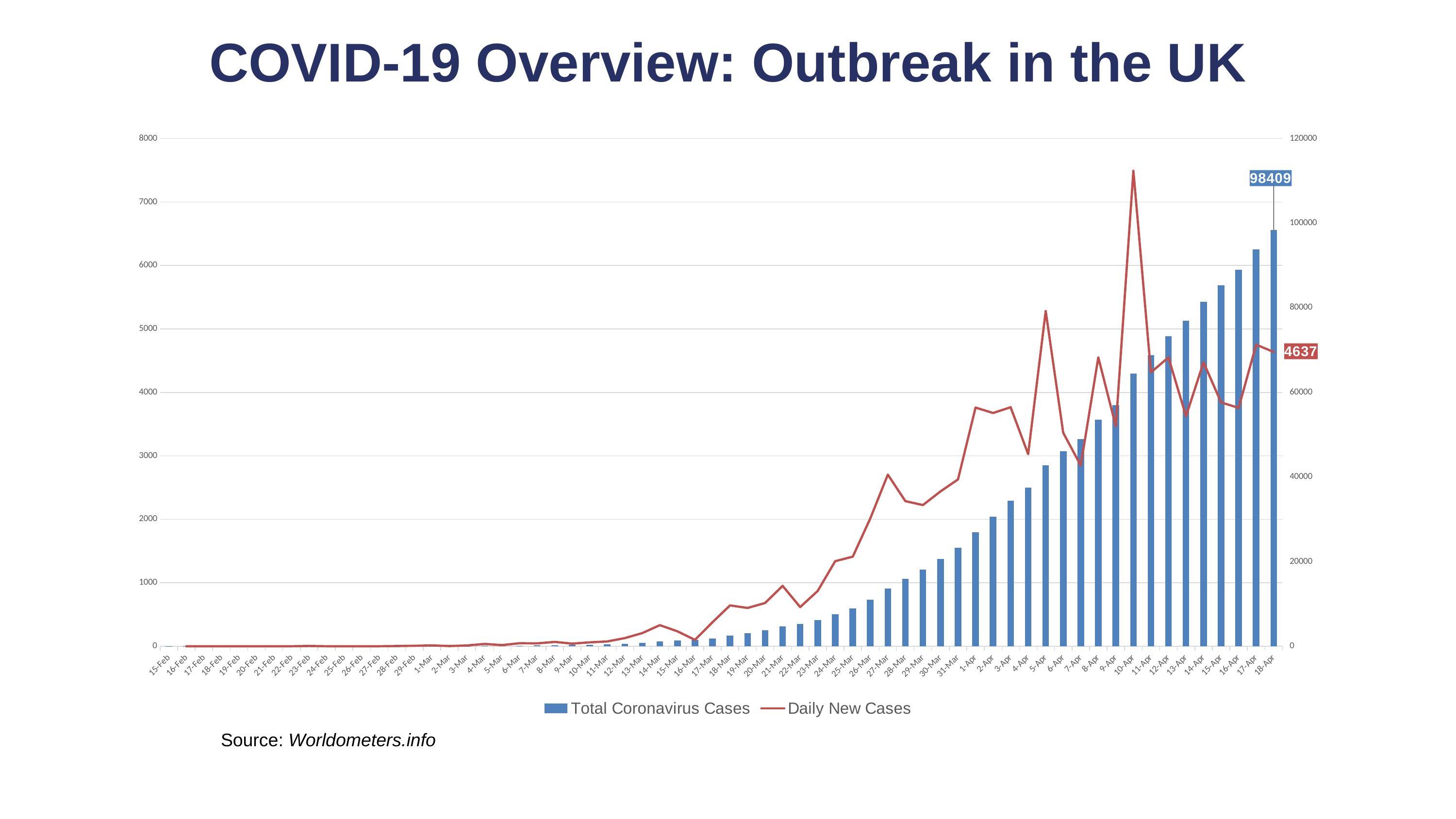
On which date does the Daily New Cases line reach its highest point? 10-Apr What kind of chart is shown on the slide? A bar chart combined with a line chart What is the value of Total Coronavirus Cases on 18-Apr? 98409 Which date has the larger value of Daily New Cases, 5-Apr or 6-Apr? 5-Apr Is the value of Total Coronavirus Cases on 1-Apr greater or less than 40000? less Is the value of Daily New Cases on 10-Apr greater or less than 7000? greater What is the value of Daily New Cases on 18-Apr? 4637 What is the title of the slide containing the chart? COVID-19 Overview: Outbreak in the UK What colour is the Daily New Cases line? Red On which date is Total Coronavirus Cases highest? 18-Apr How many series does the legend list? 2 Do the Total Coronavirus Cases bars rise or fall from 15-Feb to 18-Apr? rise